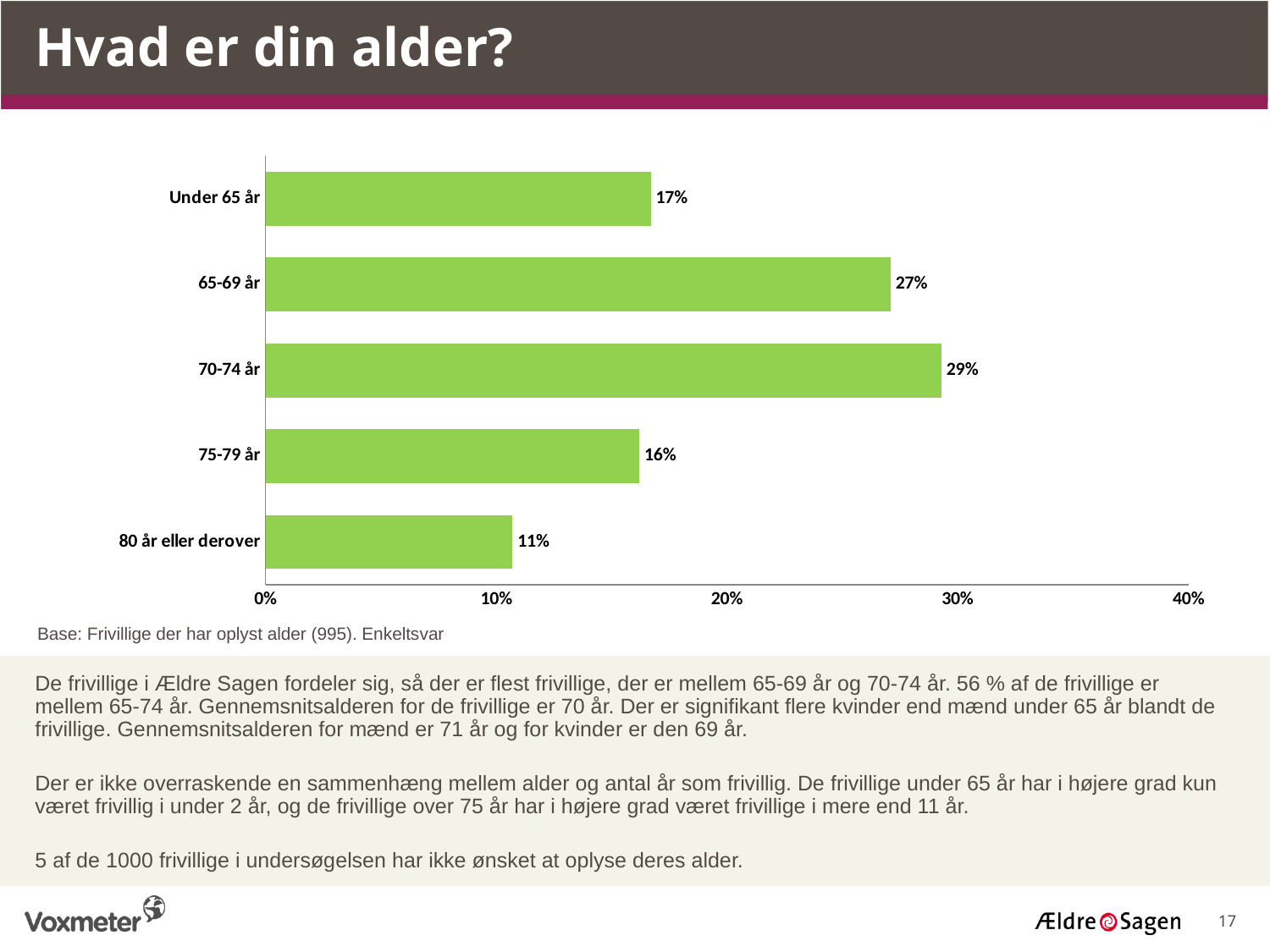
What is the value for the 70-74 år category? 29% What is the title of the slide containing the chart? Hvad er din alder? What is the difference between the values for 65-69 år and 75-79 år? 11 percentage points What kind of chart is shown on the slide? Bar chart What is the highest value shown on the horizontal axis? 40% What is the value for the Under 65 år category? 17% Which is larger, the value for Under 65 år or the value for 75-79 år? Under 65 år Is the value for 65-69 år greater or less than 20%? greater What is the value for the 80 år eller derover category? 11% Which age category has the highest value? 70-74 år How many age categories are shown in the chart? 5 Which age category has the lowest value? 80 år eller derover